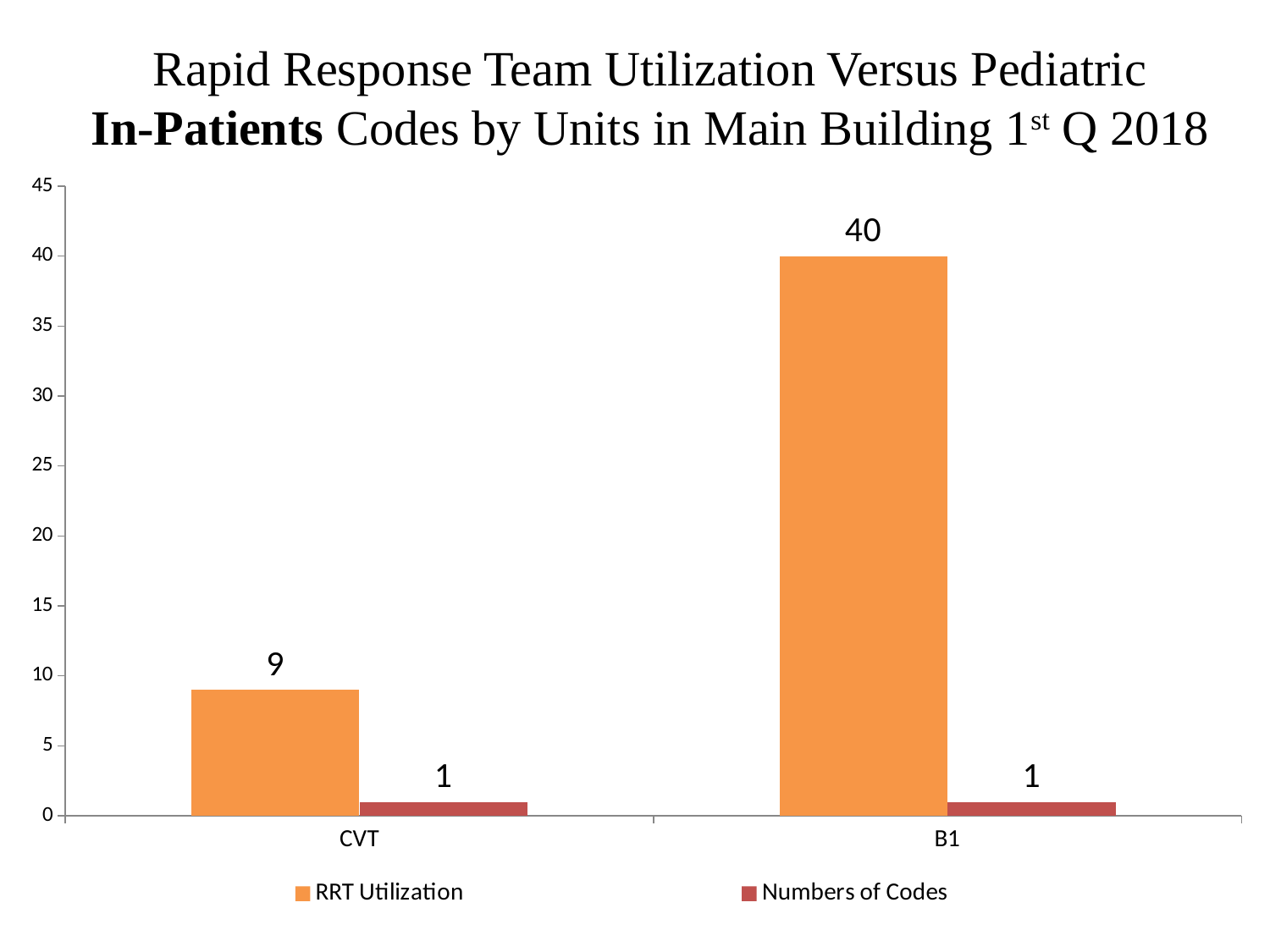
What is the RRT Utilization value for B1? 40 What is the difference in RRT Utilization between B1 and CVT? 31 Which unit has the highest RRT Utilization? B1 Which unit has the lowest RRT Utilization? CVT Does RRT Utilization rise or fall from CVT to B1? Rise Which is larger: RRT Utilization for CVT or Numbers of Codes for CVT? RRT Utilization for CVT What colour are the RRT Utilization bars? Orange How many units are shown on the x axis? 2 What is the RRT Utilization value for CVT? 9 What kind of chart is shown on the slide? Bar chart How many series does the legend list? 2 What is the Numbers of Codes value for B1? 1